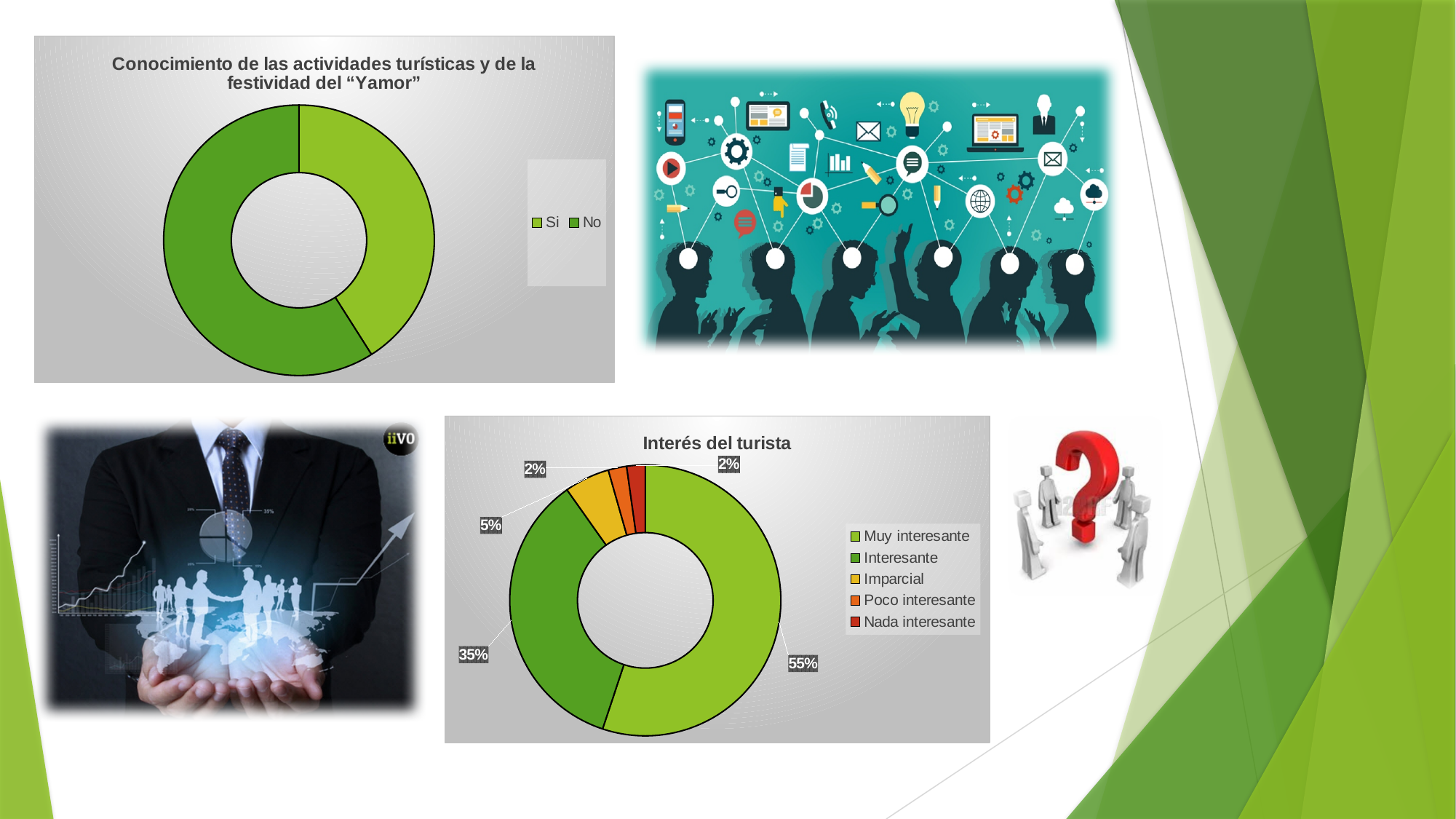
In the 'Interés del turista' chart, what colour represents 'Nada interesante'? Red In the 'Interés del turista' chart, what percentage is labelled for 'Poco interesante'? 2% In the 'Interés del turista' chart, what percentage is labelled for 'Interesante'? 35% What kind of chart is 'Interés del turista'? Doughnut chart How many categories does the legend of the chart titled 'Conocimiento de las actividades turísticas y de la festividad del "Yamor"' list? 2 How many categories does the legend of the 'Interés del turista' chart list? 5 In the 'Interés del turista' chart, what percentage is labelled for 'Imparcial'? 5% In the chart titled 'Conocimiento de las actividades turísticas y de la festividad del "Yamor"', which slice is larger, 'Si' or 'No'? No In the 'Interés del turista' chart, which is larger, 'Interesante' or 'Imparcial'? Interesante In the 'Interés del turista' chart, what is the difference between the shares of 'Muy interesante' and 'Interesante'? 20% In the 'Interés del turista' chart, which category has the largest share? Muy interesante In the 'Interés del turista' chart, what percentage is labelled for 'Muy interesante'? 55%